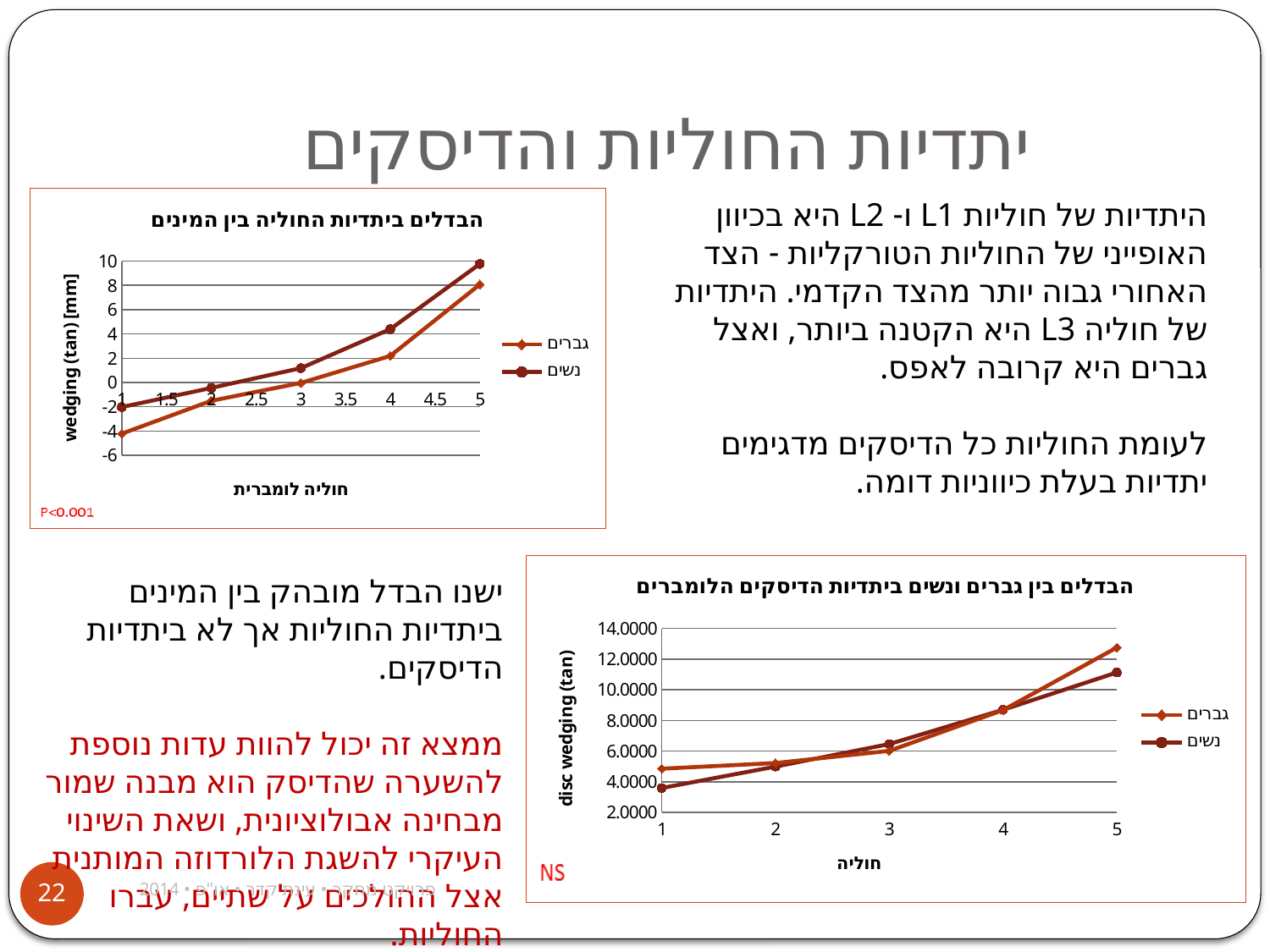
In the bottom-right chart, is the value for נשים at x = 1 greater or less than 4.0000? less In the bottom-right chart, which series has the higher value at x = 5, גברים or נשים? גברים What is the y-axis label of the top-left chart? wedging (tan) [mm] In the top-left chart, which series has the higher value at x = 1, גברים or נשים? נשים What kind of chart is the bottom-right chart titled "הבדלים בין גברים ונשים ביתדיות הדיסקים הלומבריים"? line chart What is the y-axis label of the bottom-right chart? disc wedging (tan) In the top-left chart, do the values for גברים rise or fall as x goes from 1 to 5? rise In the top-left chart, is the value for גברים at x = 1 greater or less than -2? less How many series does the legend of the top-left chart list? 2 How many x-axis categories are plotted in the bottom-right chart? 5 What kind of chart is the top-left chart titled "הבדלים ביתדיות החוליה בין המינים"? line chart In the top-left chart, is the value for נשים at x = 5 greater or less than 8? greater